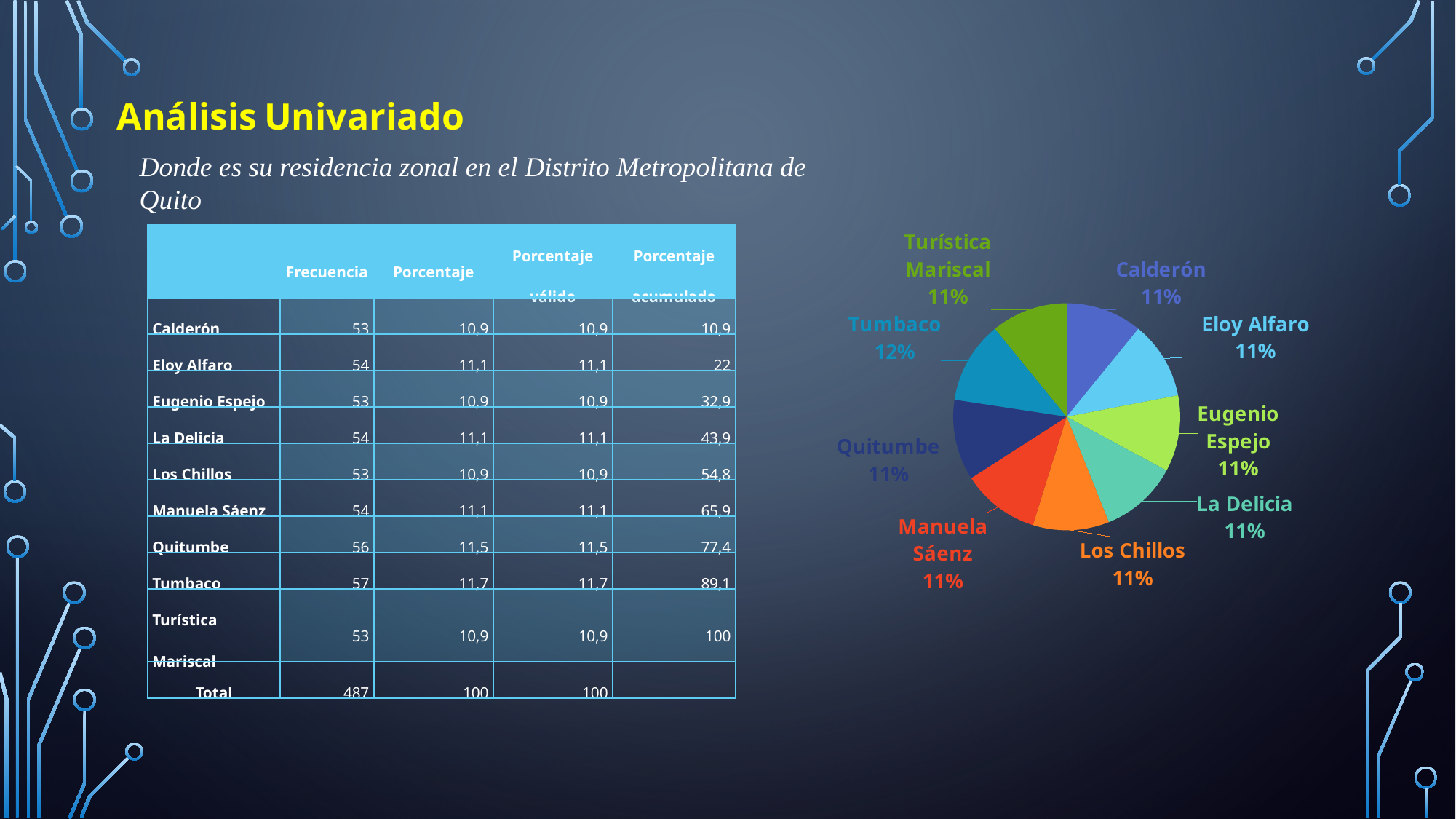
What share of the pie does Quitumbe have? 11% What percentage is shown for Turística Mariscal in the pie chart? 11% What percentage is shown for Los Chillos in the pie chart? 11% What is the difference between the shares of Tumbaco and Manuela Sáenz in the pie chart? 1% What share of the pie does Eugenio Espejo have? 11% What kind of chart is shown on the slide? pie chart How many slices does the pie chart have? 9 What share of the pie does Tumbaco have? 12% Which slice of the pie chart has the largest share? Tumbaco Which has a larger share in the pie chart, Tumbaco or La Delicia? Tumbaco What colour is the Manuela Sáenz slice in the pie chart? red